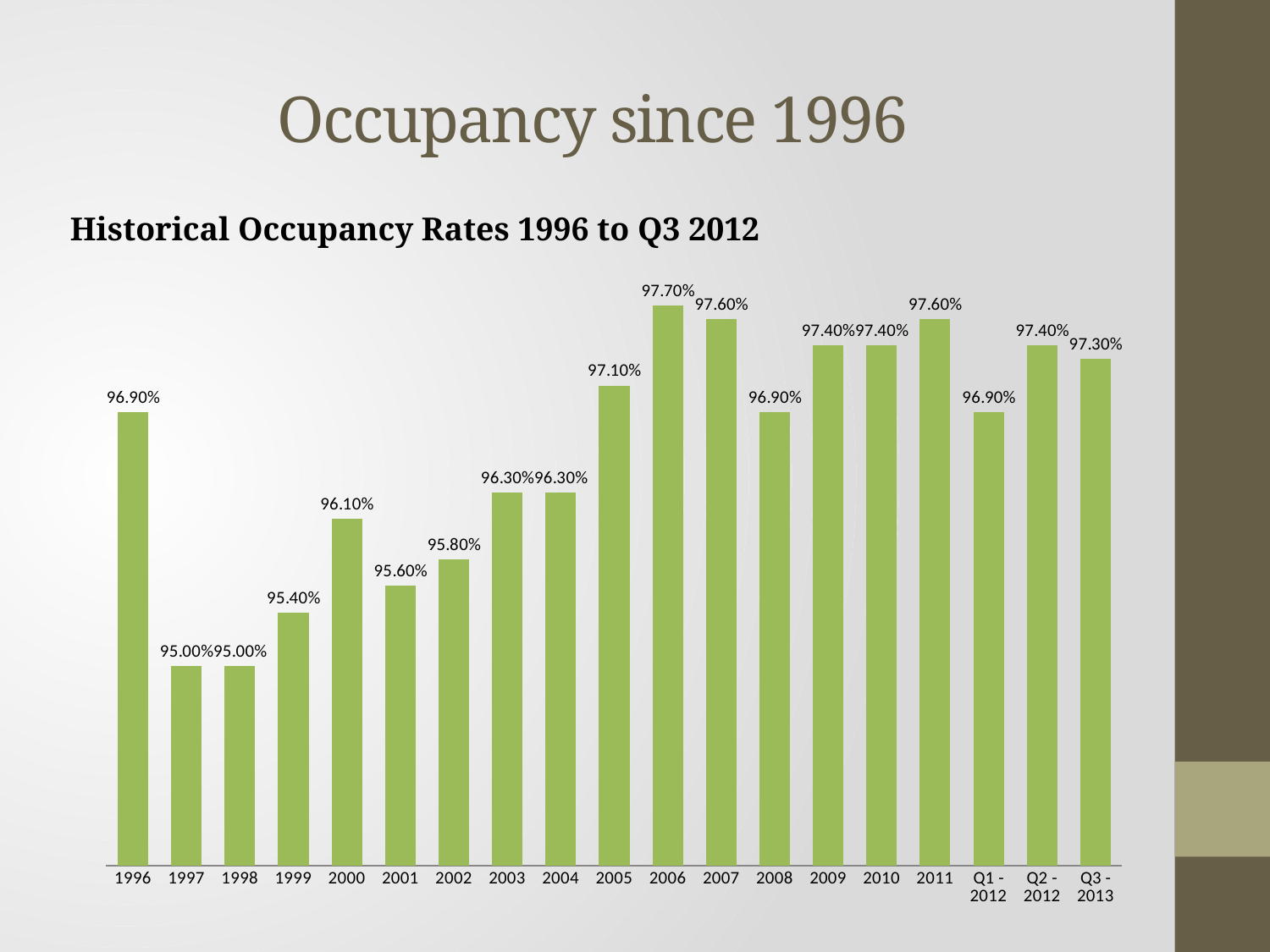
What is the occupancy rate shown for 2000? 96.10% Do the occupancy rates rise or fall from 1997 to 2006? Rise What is the occupancy rate shown for Q3 - 2013? 97.30% What is the title of the chart? Historical Occupancy Rates 1996 to Q3 2012 What is the difference between the occupancy rate in 2011 and in 2010? 0.20% Which year has the highest occupancy rate? 2006 What is the occupancy rate shown for 2006? 97.70% What type of chart is shown on the slide? Bar chart How many bars are plotted on the chart? 19 Which has a higher occupancy rate, 2005 or 2008? 2005 What is the difference between the occupancy rate in 2006 and in 1997? 2.70% What is the lowest occupancy rate shown on the chart? 95.00%